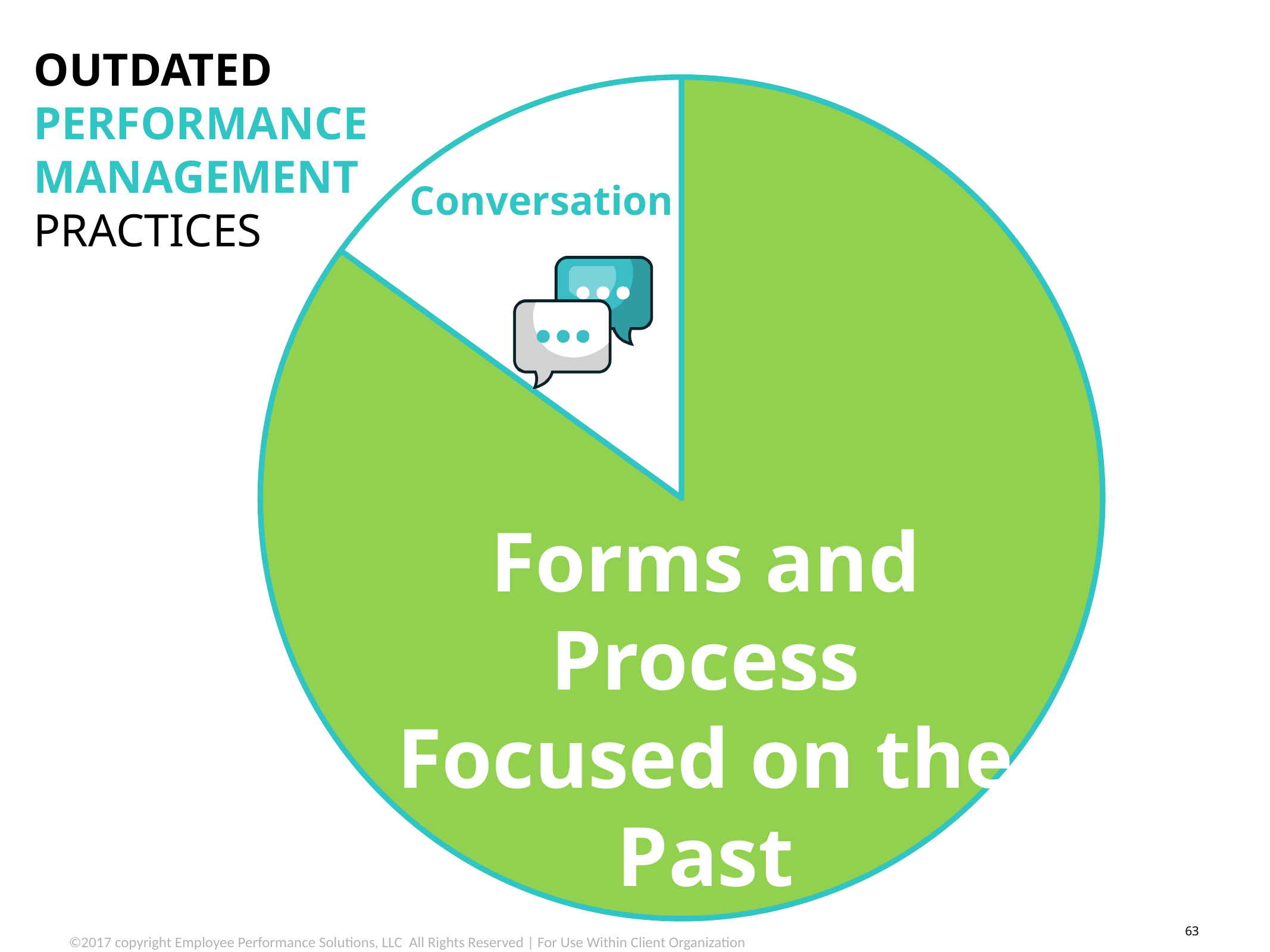
Which slice of the pie chart is the smallest? Conversation What is the title of the slide containing the pie chart? Outdated Performance Management Practices What colour is the Forms and Process Focused on the Past slice? Green Which slice of the pie chart is the largest? Forms and Process Focused on the Past What kind of chart is shown on the slide? Pie chart How many slices does the pie chart have? 2 Which slice is larger, Conversation or Forms and Process Focused on the Past? Forms and Process Focused on the Past